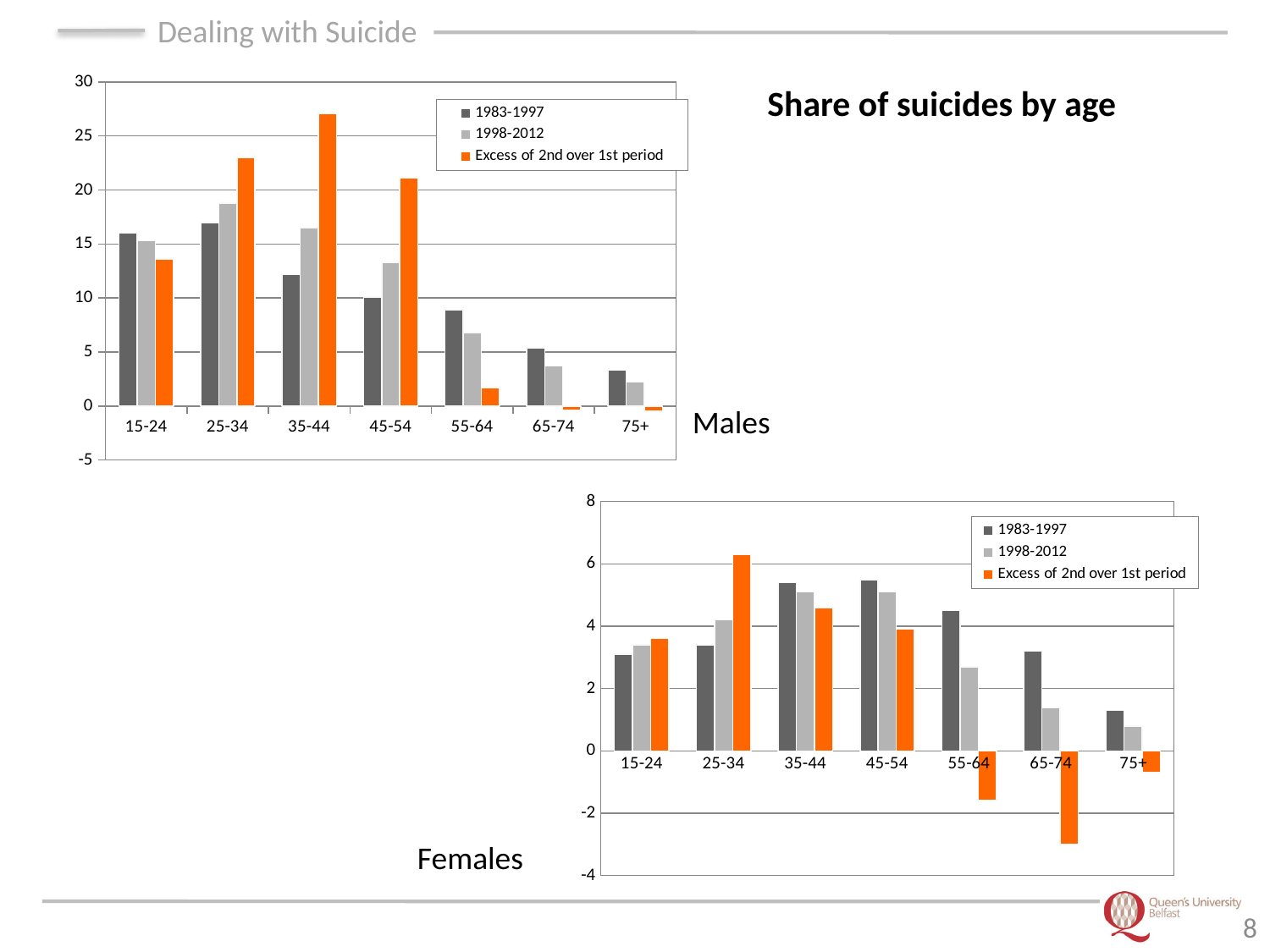
In the Males chart, is the value for Excess of 2nd over 1st period at 35-44 greater or less than 25? greater In the Males chart, which age group has the lowest value for 1983-1997? 75+ In the Males chart, which age group has the highest value for Excess of 2nd over 1st period? 35-44 In the Males chart, is the value for 1983-1997 at 55-64 greater or less than 10? less In the Females chart, at 55-64, which is larger: the 1983-1997 value or the 1998-2012 value? 1983-1997 What kind of chart is the Males chart? bar chart In the Females chart, which age group has the highest value for Excess of 2nd over 1st period? 25-34 How many series does the legend of the Males chart list? 3 In the Females chart, which age group has the lowest value for Excess of 2nd over 1st period? 65-74 How many age categories are shown on the x axis of the Females chart? 7 In the Males chart, which age group has the highest value for 1998-2012? 25-34 In the Females chart, is the value for Excess of 2nd over 1st period at 65-74 greater or less than -2? less